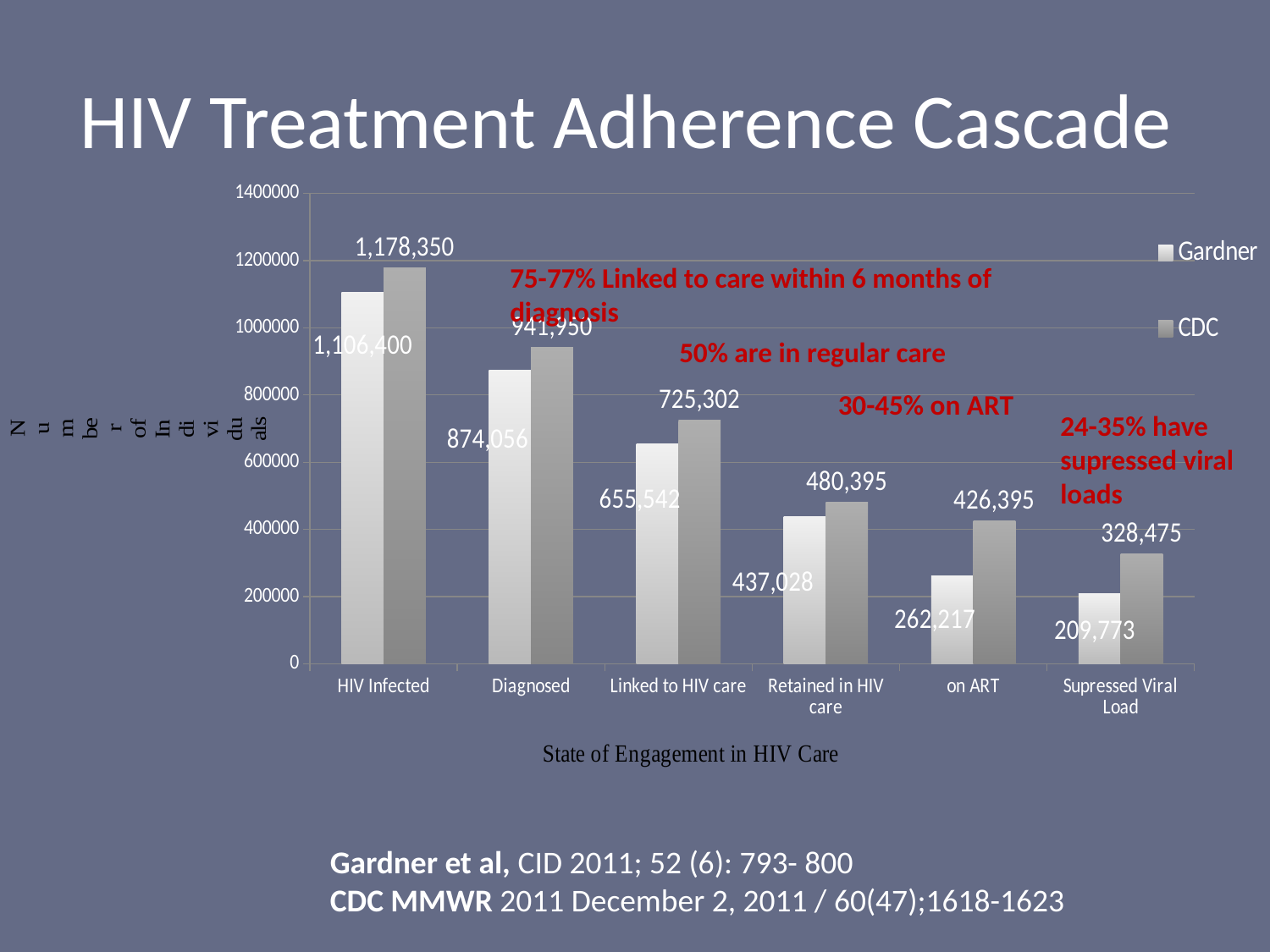
What is the CDC value for HIV Infected? 1,178,350 Which category has the lowest Gardner value? Supressed Viral Load What is the Gardner value for HIV Infected? 1,106,400 How many categories are shown on the x axis? 6 Which is larger for Retained in HIV care, the Gardner value or the CDC value? CDC What is the CDC value for Linked to HIV care? 725,302 What is the difference between the CDC and Gardner values for on ART? 164,178 What is the CDC value for Supressed Viral Load? 328,475 What is the Gardner value for on ART? 262,217 Do the values fall or rise moving from HIV Infected to Supressed Viral Load along the x axis? fall What kind of chart is shown on the slide? bar chart How many series does the legend list? 2